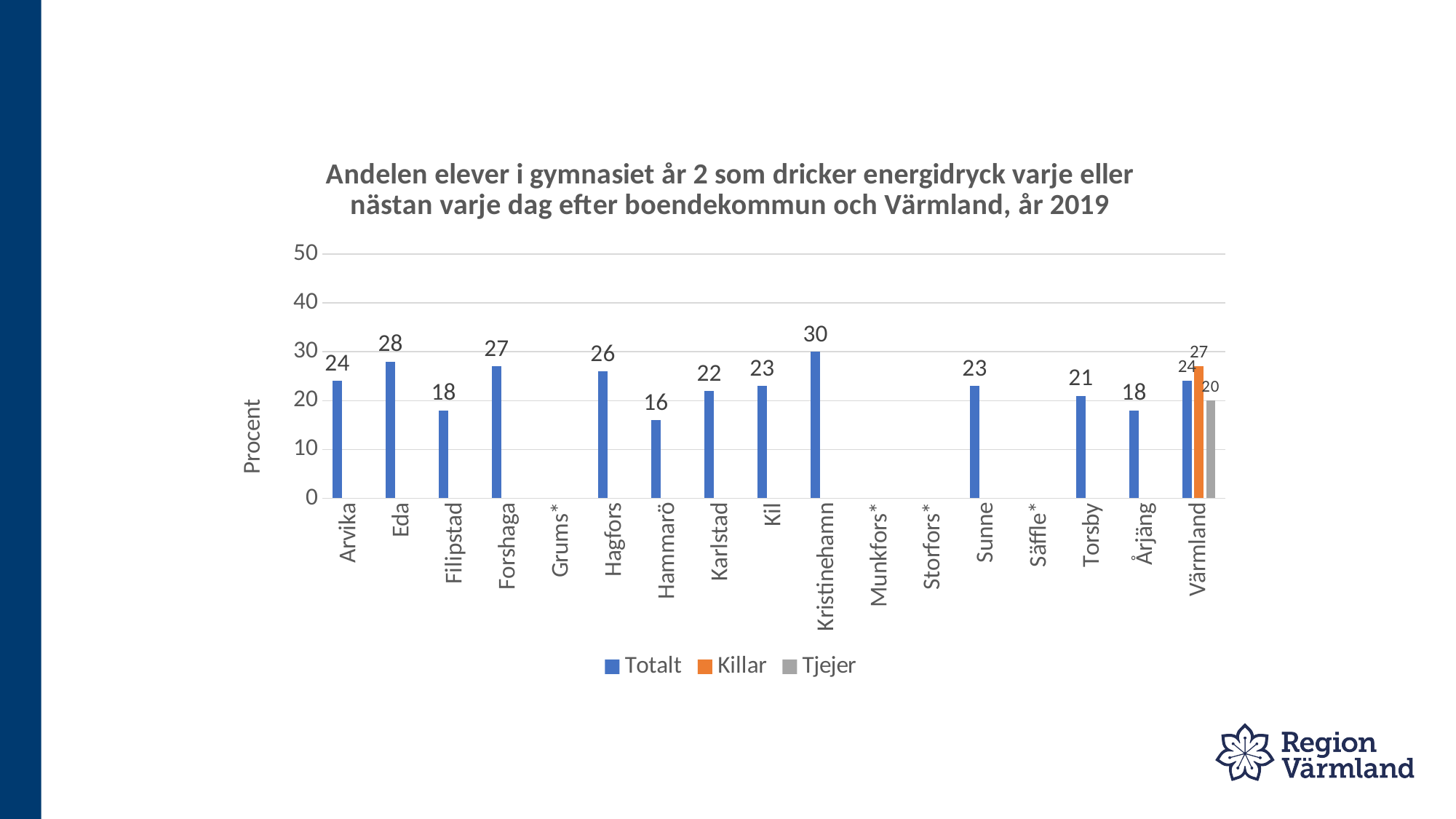
What is the difference between the Killar and Tjejer values for Värmland? 7 Which municipality has the highest value? Kristinehamn How many series does the legend list? 3 What is the Killar value for Värmland? 27 How many categories are shown on the x axis? 17 What is the value for Hammarö? 16 What is the difference between the values for Eda and Filipstad? 10 Which municipality with a plotted bar has the lowest value? Hammarö What is the label on the vertical axis? Procent What kind of chart is shown on the slide? Bar chart Which is larger, the value for Forshaga or the value for Hagfors? Forshaga What is the value for Kristinehamn? 30